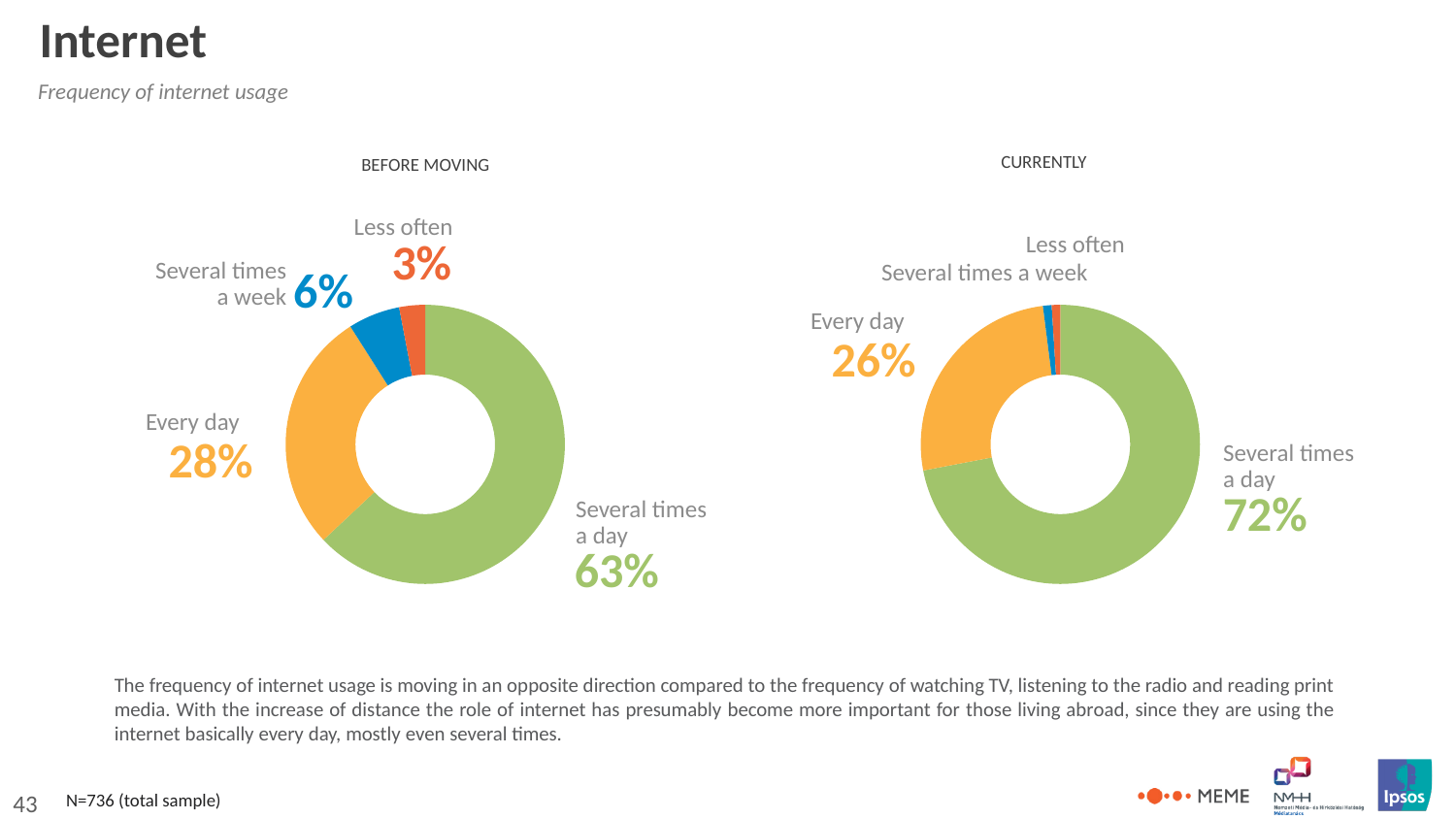
In the BEFORE MOVING chart, which category has the smallest share? Less often In the CURRENTLY chart, which category has the largest share? Several times a day In the BEFORE MOVING chart, which category has the largest share? Several times a day In the CURRENTLY chart, what is the value for Every day? 26% In the BEFORE MOVING chart, what share of respondents used the internet several times a day? 63% In the BEFORE MOVING chart, what is the value for Less often? 3% In the BEFORE MOVING chart, what is the value for Every day? 28% What type of chart is used on this slide? Pie (donut) chart In the CURRENTLY chart, what share of respondents use the internet several times a day? 72% What is the difference between the Several times a day share in the CURRENTLY chart and in the BEFORE MOVING chart? 9 percentage points In the BEFORE MOVING chart, what is the difference between Every day and Several times a week? 22 percentage points In the BEFORE MOVING chart, what is the value for Several times a week? 6%